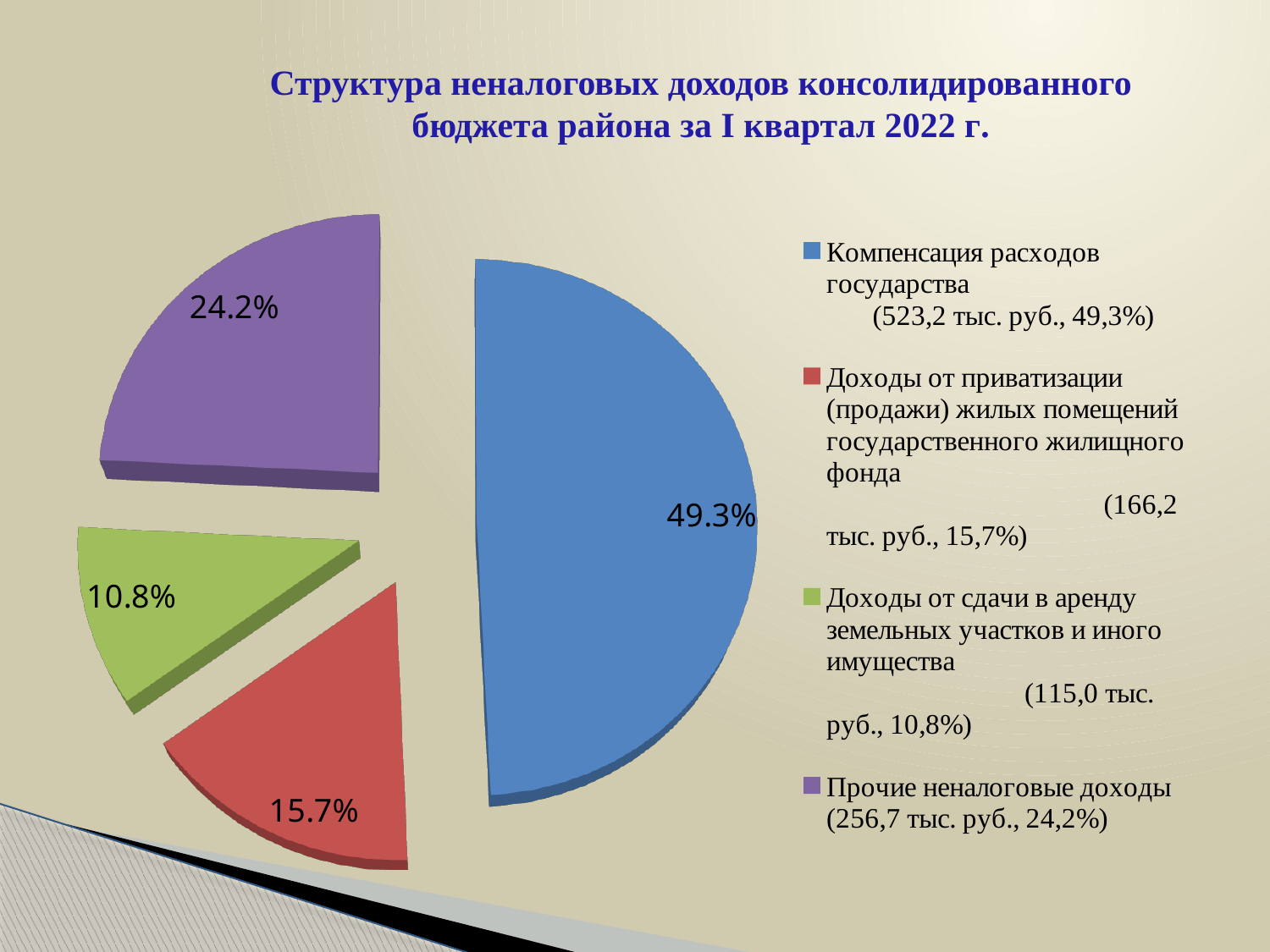
What share of the pie does "Доходы от сдачи в аренду земельных участков и иного имущества" have? 10.8% What share of the pie does "Прочие неналоговые доходы" have? 24.2% Which category has the largest slice of the pie? Компенсация расходов государства How many entries does the legend list? 4 What kind of chart is shown on the slide? Pie chart How many slices does the pie chart have? 4 What share of the pie does "Компенсация расходов государства" have? 49.3% What is the difference in percentage points between the "Прочие неналоговые доходы" slice and the "Доходы от приватизации (продажи) жилых помещений государственного жилищного фонда" slice? 8.5 What colour is the slice for "Компенсация расходов государства"? Blue Which slice is larger: "Прочие неналоговые доходы" or "Доходы от сдачи в аренду земельных участков и иного имущества"? Прочие неналоговые доходы Which category has the smallest slice of the pie? Доходы от сдачи в аренду земельных участков и иного имущества